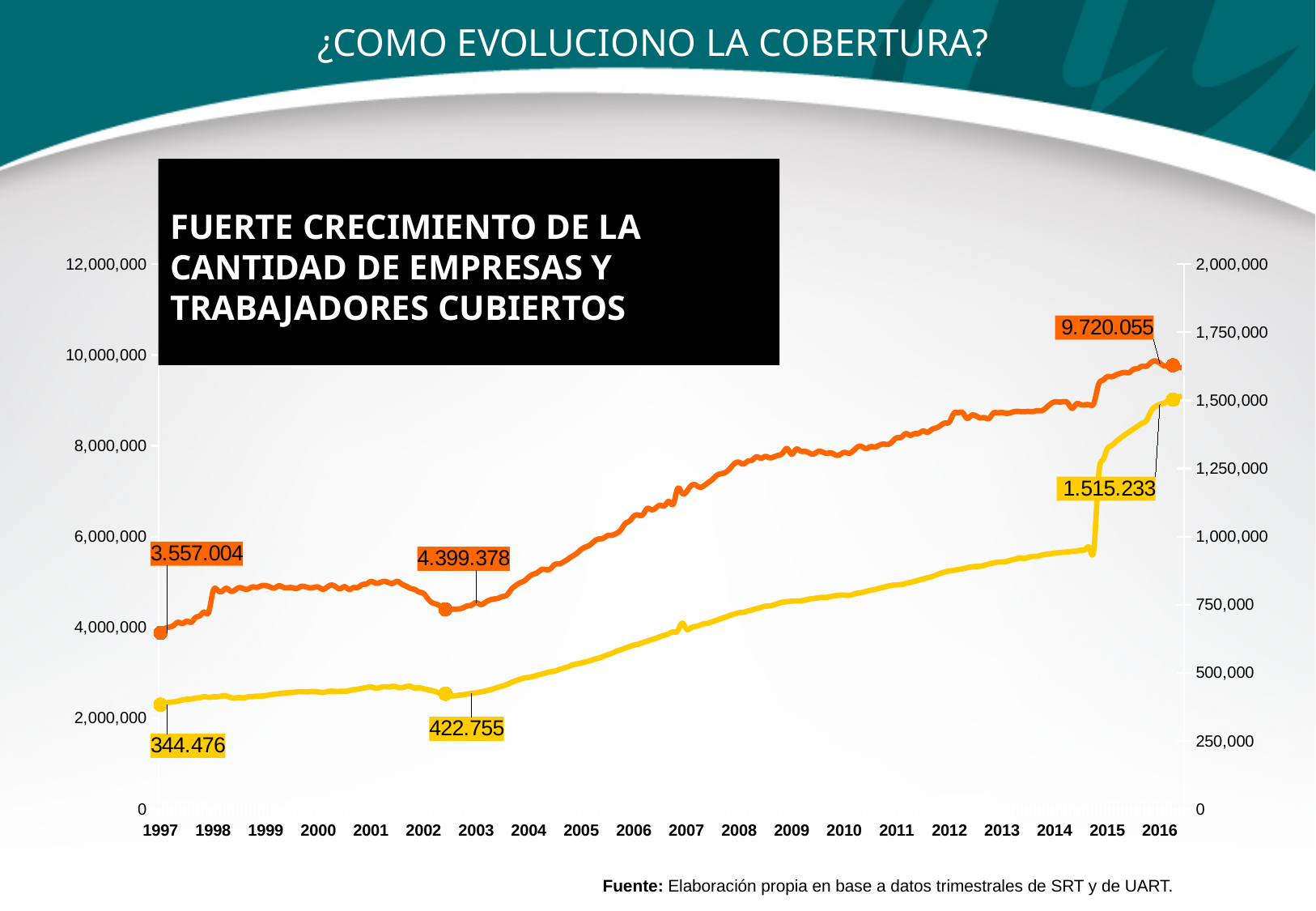
Do the values of the orange line generally rise or fall from 1997 to 2016? rise What is the final labelled value of the yellow line in 2016? 1.515.233 What is the title of the slide? ¿COMO EVOLUCIONO LA COBERTURA? What kind of chart is shown on the slide? line chart By how much did the yellow line's labelled value increase from 1997 (344.476) to 2016 (1.515.233)? 1.170.757 What is the labelled value of the yellow line at the dip around 2002–2003? 422.755 What is the final labelled value of the orange line in 2016? 9.720.055 By how much did the orange line's labelled value increase from 1997 (3.557.004) to 2016 (9.720.055)? 6.163.051 What is the data label on the orange line at its starting point in 1997? 3.557.004 How many year labels are shown on the x axis? 20 What is the labelled value of the orange line at the dip around 2002–2003? 4.399.378 What is the data label on the yellow line at its starting point in 1997? 344.476